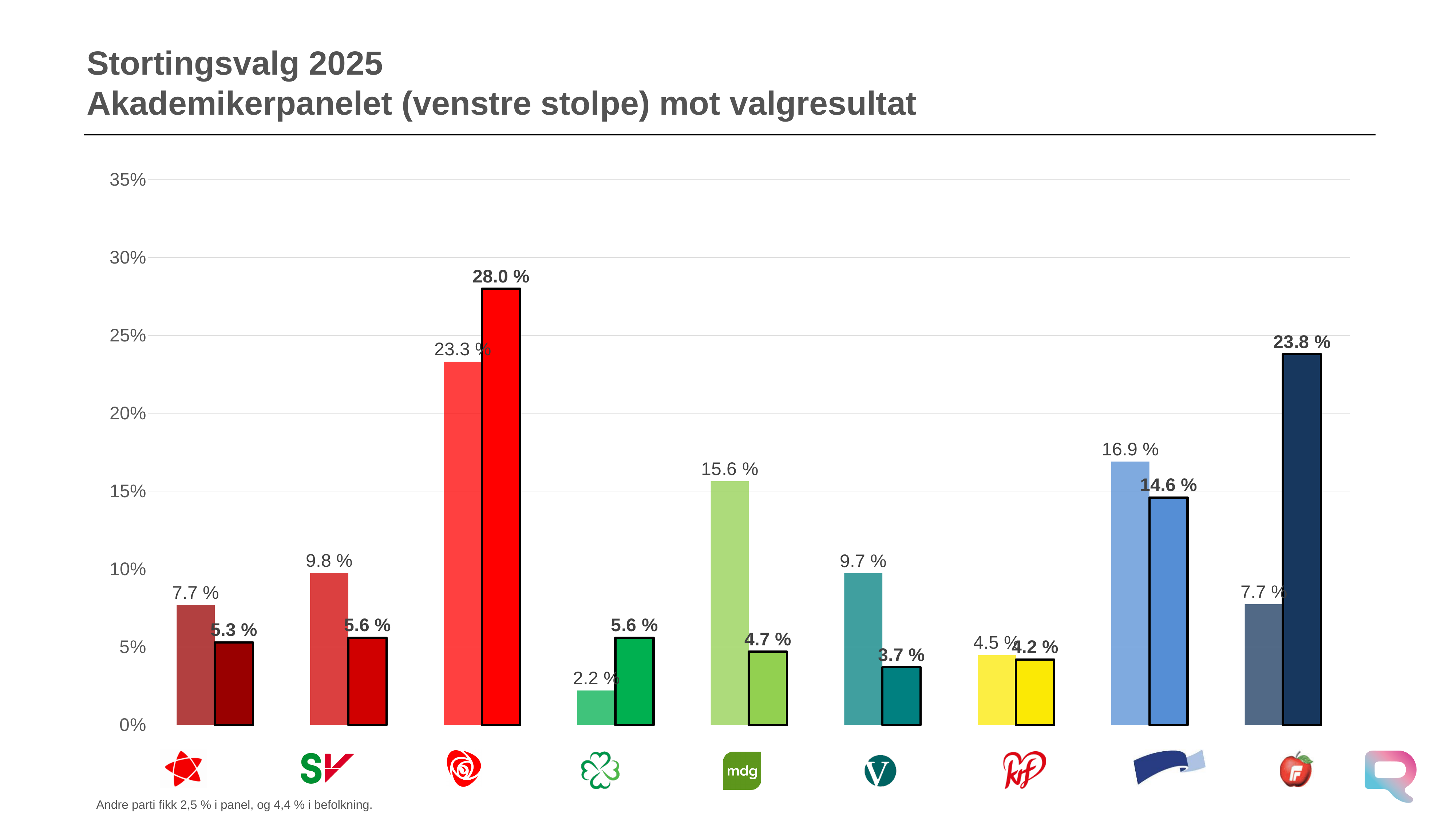
What is the highest election result (right bar) value shown in the chart? 28.0 % What is the Akademikerpanelet (left bar) value for V? 9.7 % How many parties (categories) are shown on the x axis of the chart? 9 What is the election result (right bar) value for KrF? 4.2 % What is the lowest Akademikerpanelet (left bar) value shown in the chart? 2.2 % What is the election result (right bar) value for mdg? 4.7 % What is the election result (right bar) value for SV? 5.6 % What is the Akademikerpanelet (left bar) value for mdg? 15.6 % What kind of chart is shown on the slide? bar chart What is the Akademikerpanelet (left bar) value for SV? 9.8 % For mdg, what is the difference between the Akademikerpanelet value and the election result? 10.9 % For V, which is larger: the Akademikerpanelet value or the election result? Akademikerpanelet